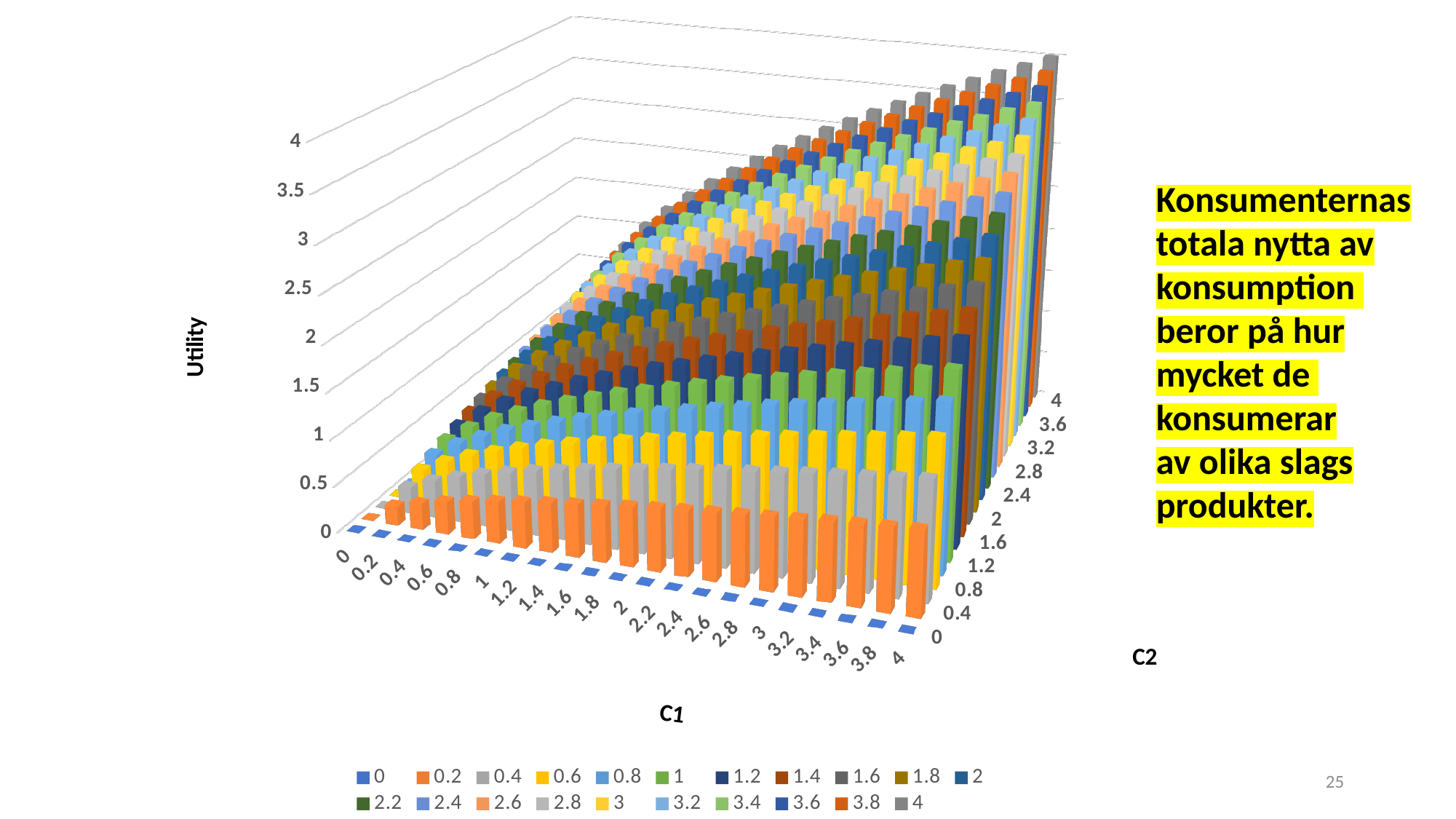
What are the labels of the two horizontal axes? C1 and C2 How many series does the legend list? 21 What is the label of the vertical axis? Utility Which series in the legend has bars that are flat at zero for every C1 value? 0 How many categories are shown along the C1 axis? 21 Is the bar for C1 = 4 in the series labelled 4 greater or less than 3? greater Which is taller: the bar for C1 = 4 in the series 0.2, or the bar for C1 = 0.2 in the series 0.2? C1 = 4 At which combination of C1 and C2 is the tallest bar found? C1 = 4, C2 = 4 Is the bar for C1 = 0.2 in the series labelled 0.2 greater or less than 0.5? less For the series labelled 0.2, do the bars rise or fall as C1 increases from 0 to 4? rise What kind of chart is shown on the slide? 3D bar chart What is the highest value shown on the Utility axis? 4